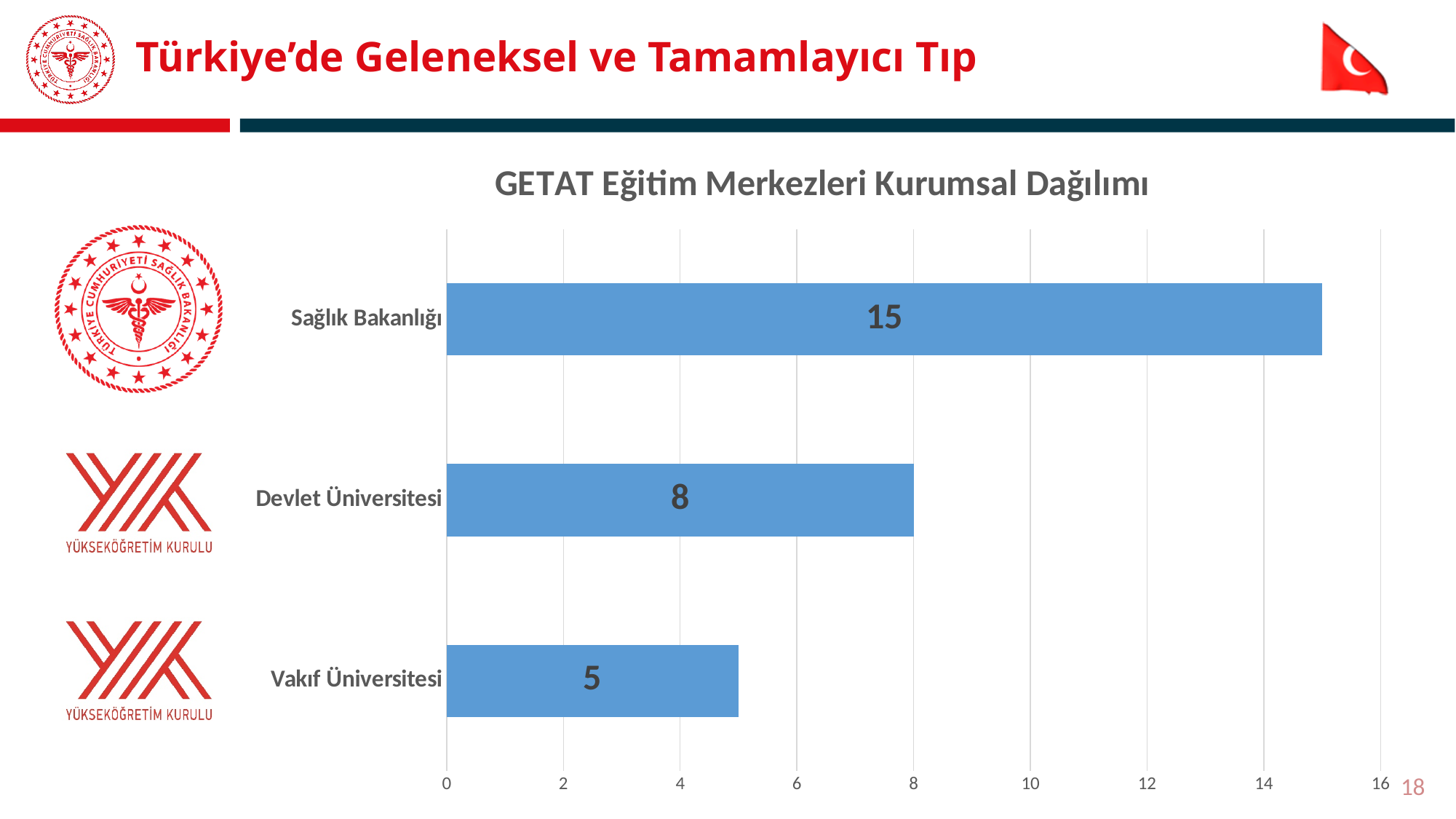
What is the value for Vakıf Üniversitesi? 5 What is the difference between the values for Sağlık Bakanlığı and Devlet Üniversitesi? 7 What is the title of the chart? GETAT Eğitim Merkezleri Kurumsal Dağılımı What is the difference between the values for Devlet Üniversitesi and Vakıf Üniversitesi? 3 How many categories are shown in the chart? 3 Which category has the lowest value? Vakıf Üniversitesi What is the value for Sağlık Bakanlığı? 15 Which category has the highest value? Sağlık Bakanlığı Which is larger, the value for Devlet Üniversitesi or Vakıf Üniversitesi? Devlet Üniversitesi What is the value for Devlet Üniversitesi? 8 What kind of chart is shown on the slide? bar chart Is the value for Sağlık Bakanlığı greater or less than 10? greater